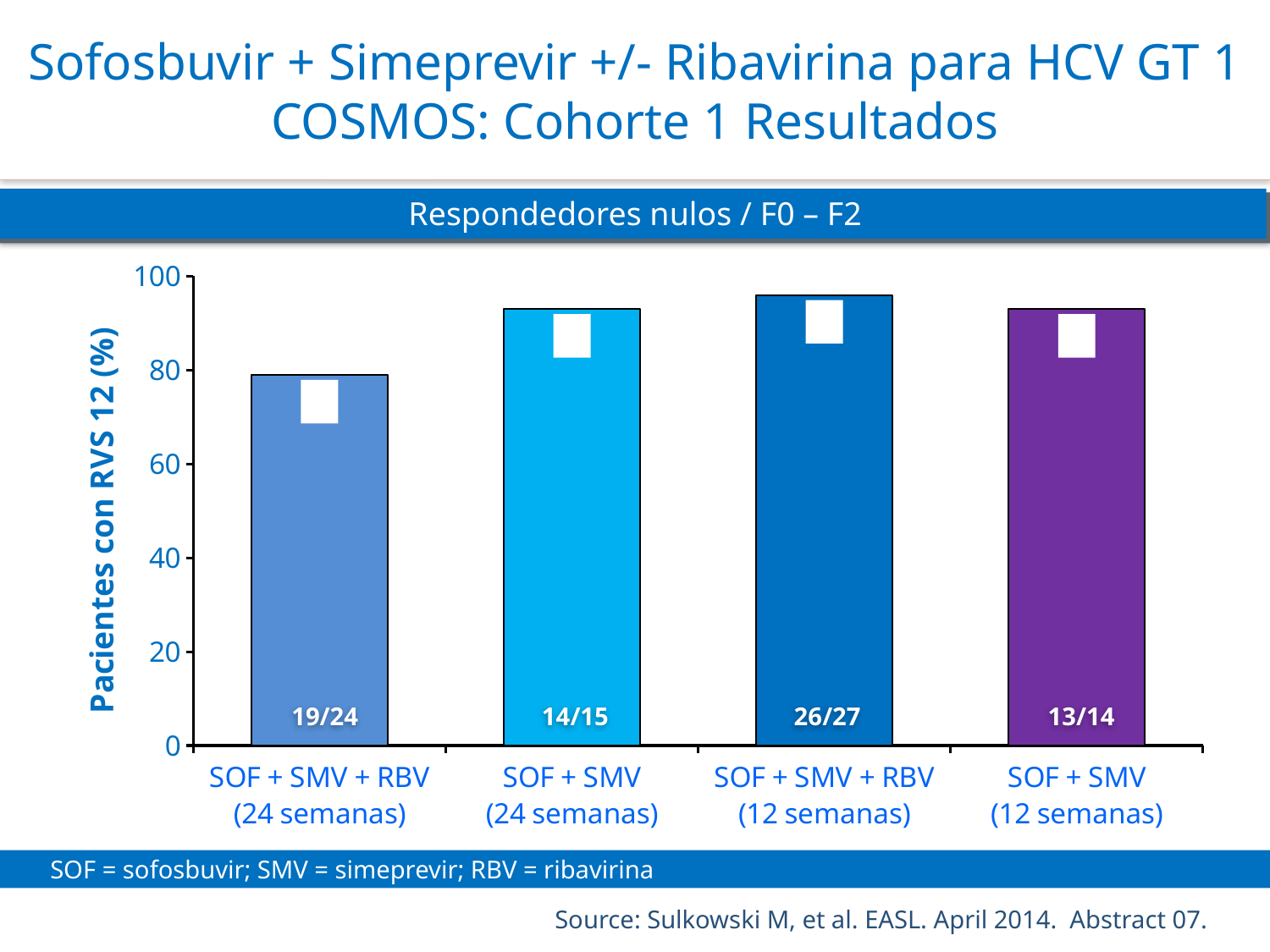
How many treatment arms (bars) are shown in the chart? 4 Which bar is taller: SOF + SMV + RBV (24 semanas) or SOF + SMV + RBV (12 semanas)? SOF + SMV + RBV (12 semanas) Is the value for SOF + SMV + RBV (12 semanas) greater or less than 80? greater Is the value for SOF + SMV + RBV (24 semanas) greater or less than 60? greater What is the data label shown on the bar for SOF + SMV + RBV (12 semanas)? 26/27 What is the data label shown on the bar for SOF + SMV (12 semanas)? 13/14 What is the data label shown on the bar for SOF + SMV (24 semanas)? 14/15 Which treatment arm has the lowest bar? SOF + SMV + RBV (24 semanas) Which treatment arm has the highest bar? SOF + SMV + RBV (12 semanas) What is the data label shown on the bar for SOF + SMV + RBV (24 semanas)? 19/24 What is the label of the vertical axis? Pacientes con RVS 12 (%) What type of chart is shown on the slide? Bar chart